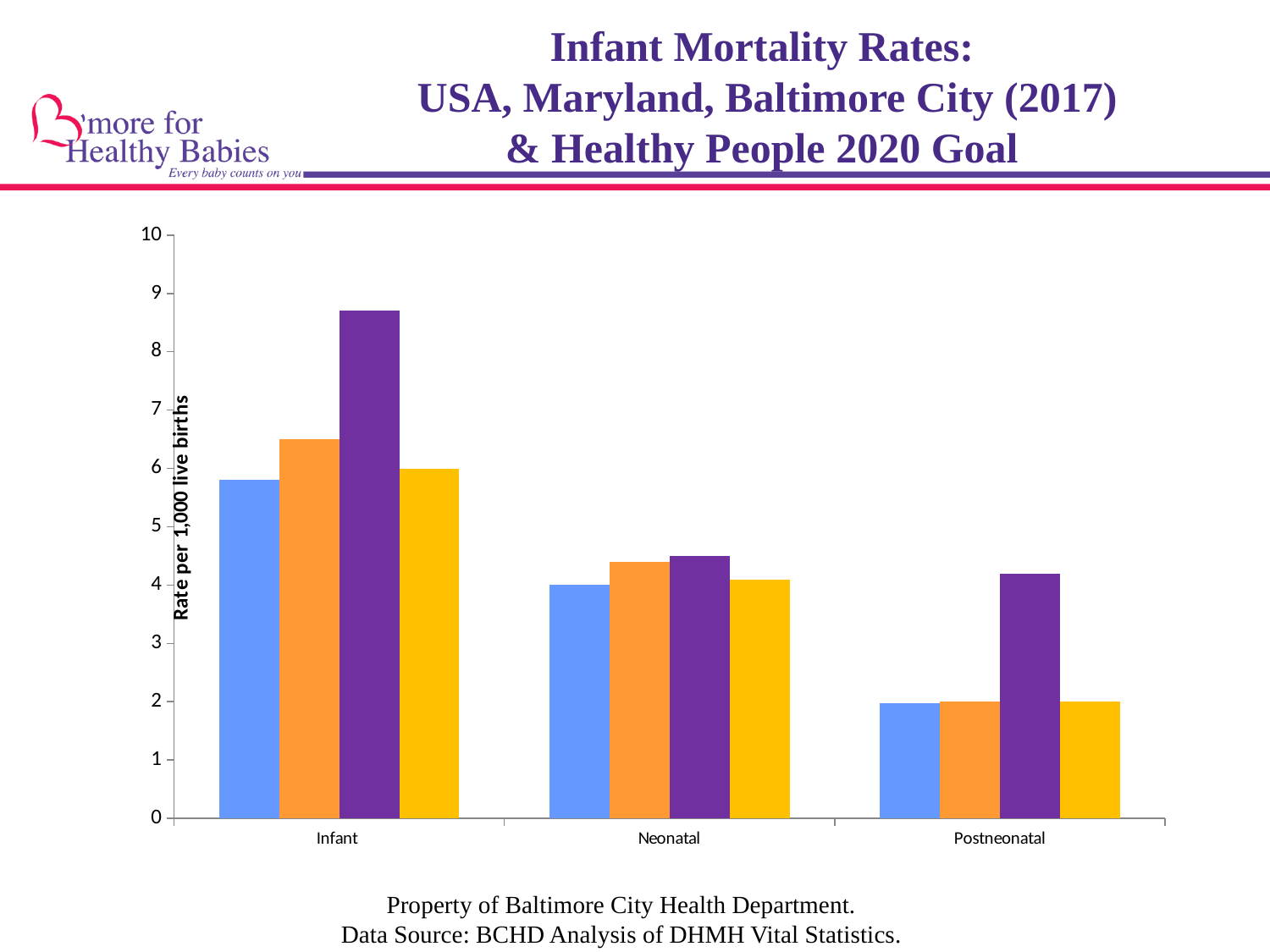
What is the label on the vertical axis of the chart? Rate per 1,000 live births Is the value of the orange bar for Infant greater or less than 6? greater Which coloured bar is the tallest in the Postneonatal category? purple Is the value of the blue bar for Neonatal greater or less than 5? less Is the value of the purple bar for Postneonatal greater or less than 3? greater What kind of chart is shown on the slide? bar chart Which is larger: the purple bar for Infant or the purple bar for Neonatal? Infant How many categories are shown on the x axis of the chart? 3 Which coloured bar is the tallest in the Infant category? purple How many bars are plotted for each category on the chart? 4